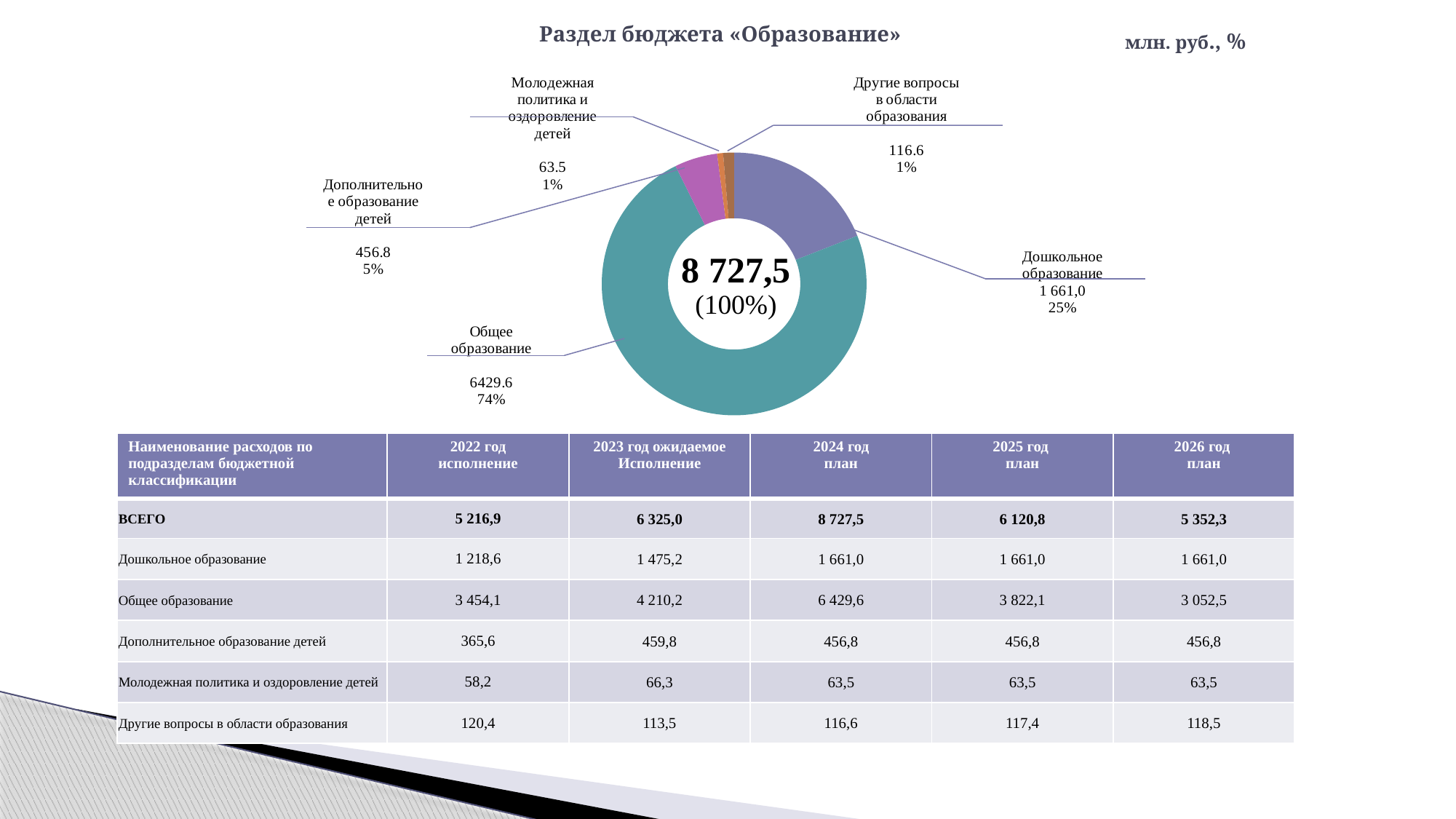
What is the value shown for Другие вопросы в области образования in the donut chart? 116.6 What percentage is shown for Дошкольное образование in the donut chart? 25% What type of chart is shown on the slide? Pie (donut) chart What is the value shown for Дополнительное образование детей in the donut chart? 456.8 What is the value shown for Молодежная политика и оздоровление детей in the donut chart? 63.5 How many slices does the donut chart have? 5 What is the value shown for Дошкольное образование in the donut chart? 1 661,0 What share of the donut chart does Общее образование take? 74% Which category has the largest slice in the donut chart? Общее образование What total value is shown in the centre of the donut chart? 8 727,5 What is the value shown for Общее образование in the donut chart? 6429.6 Which category has the smallest slice in the donut chart? Молодежная политика и оздоровление детей